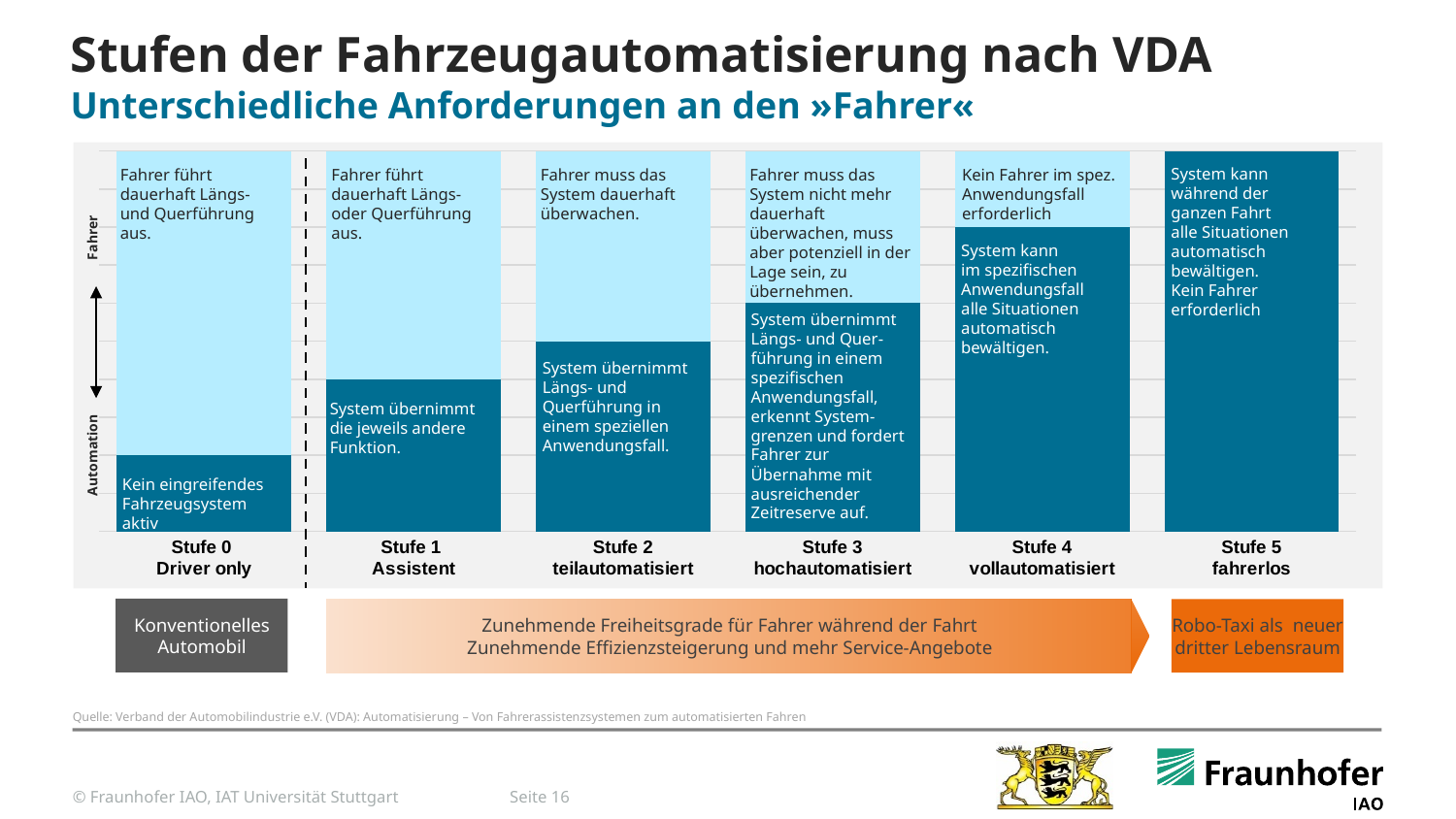
Which level is labelled "Assistent"? Stufe 1 What is the label of the first level on the left of the diagram? Stufe 0 Driver only Which level has the largest light-blue (Fahrer) portion of its column? Stufe 0 Which has the larger dark-blue (Automation) portion, Stufe 1 or Stufe 4? Stufe 4 How many automation levels (Stufen) are shown along the bottom of the diagram? 6 Which level is labelled "hochautomatisiert"? Stufe 3 Which level has no light-blue (Fahrer) portion at all, being entirely dark blue (Automation)? Stufe 5 What are the two labels on the vertical axis at the left of the diagram? Fahrer and Automation Does the dark-blue (Automation) portion of the columns increase or decrease from Stufe 0 to Stufe 5? increase What is the label of the last level on the right of the diagram? Stufe 5 fahrerlos